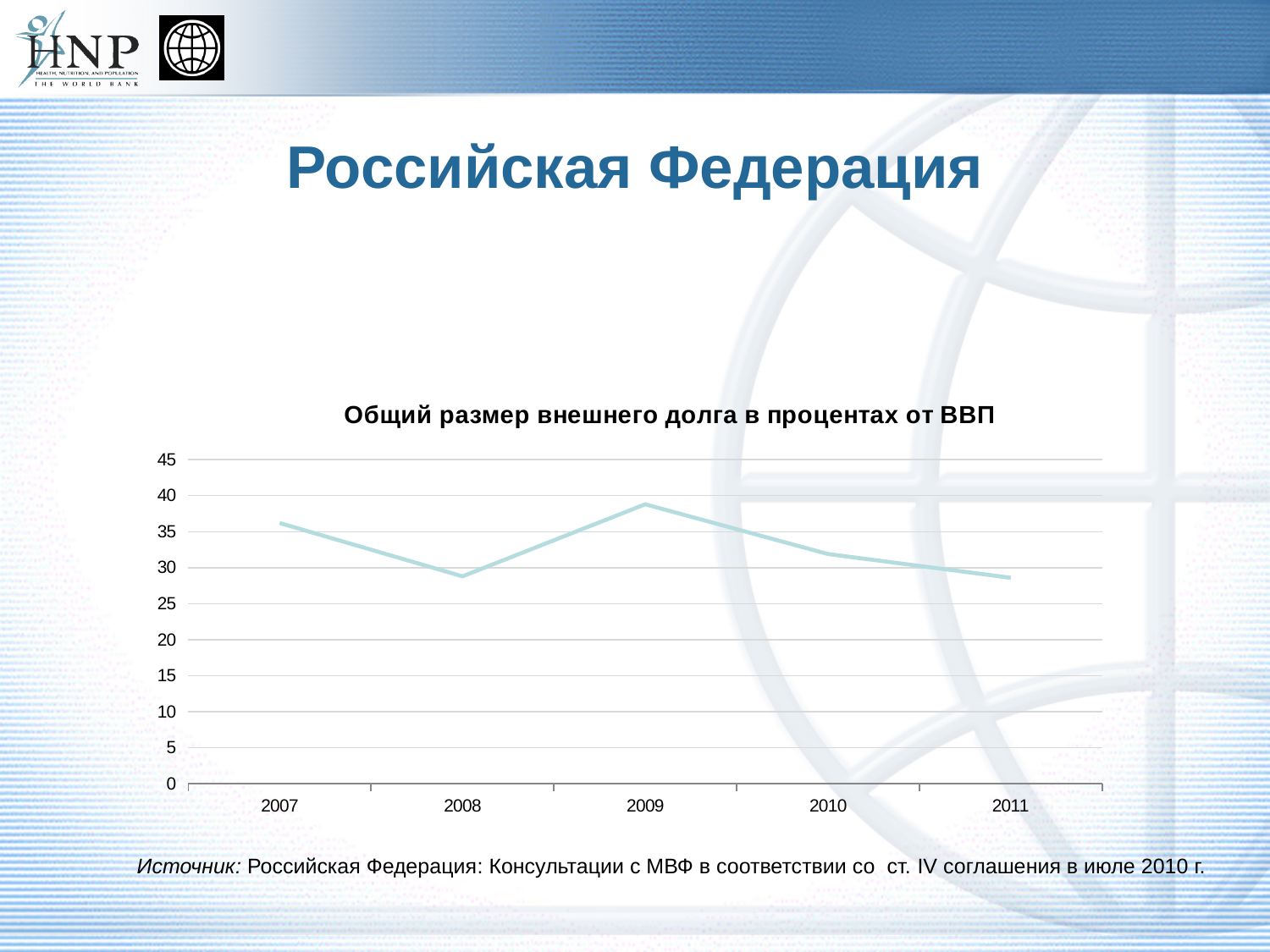
What is the title of the chart? Общий размер внешнего долга в процентах от ВВП Is the value for 2009 greater or less than 35? greater Is the value for 2010 greater or less than 30? greater Is the value for 2007 greater or less than 35? greater How many years are plotted on the x axis of the chart? 5 Do the values rise or fall from 2009 to 2011? fall What kind of chart is shown on the slide? line chart Which year has the highest value in the chart? 2009 Which is larger, the value for 2007 or the value for 2010? 2007 What is the highest value shown on the y axis of the chart? 45